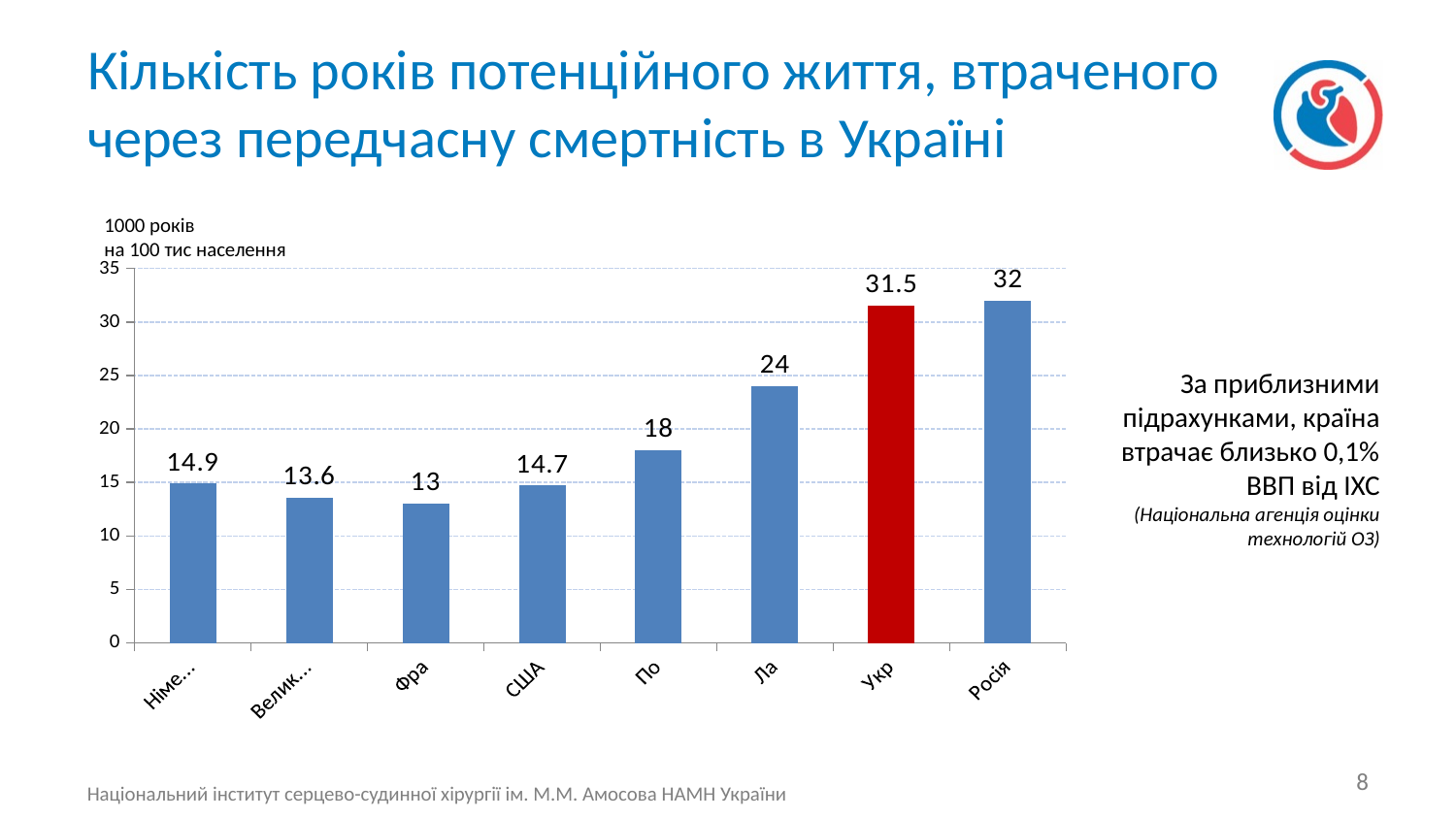
What is the value for Росія? 32 What is the value for Укр? 31.5 Which is larger, the value for Ла or the value for По? Ла What is the value for США? 14.7 Which category has the lowest value? Фра What is the value for Ла? 24 What is the value for Фра? 13 What is the difference between the values for Ла and По? 6 What is the difference between the values for Росія and Укр? 0.5 How many bars are shown in the chart? 8 Which category's bar is coloured red? Укр Which category has the highest value? Росія